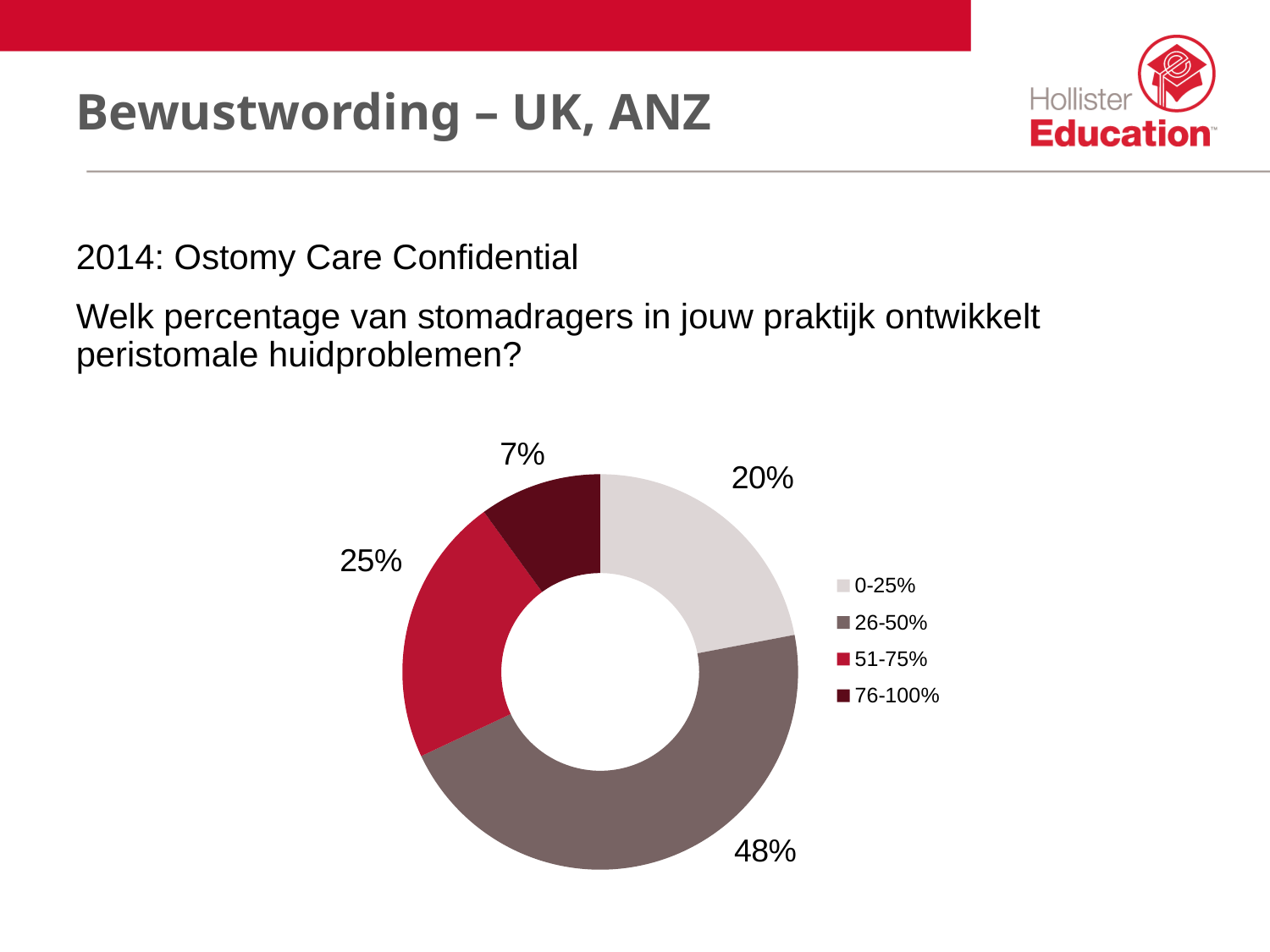
What colour is the 51-75% slice? Red How many categories does the chart show? 4 Which is larger, the 0-25% value or the 51-75% value? 51-75% What is the difference between the 26-50% and 51-75% values? 23% What is the value for the 0-25% category? 20% What is the difference between the 0-25% and 76-100% values? 13% What kind of chart is shown on the slide? Doughnut (pie) chart Which category has the largest share? 26-50% What is the value for the 26-50% category? 48% What is the value for the 76-100% category? 7% Which category has the smallest share? 76-100% What is the value for the 51-75% category? 25%